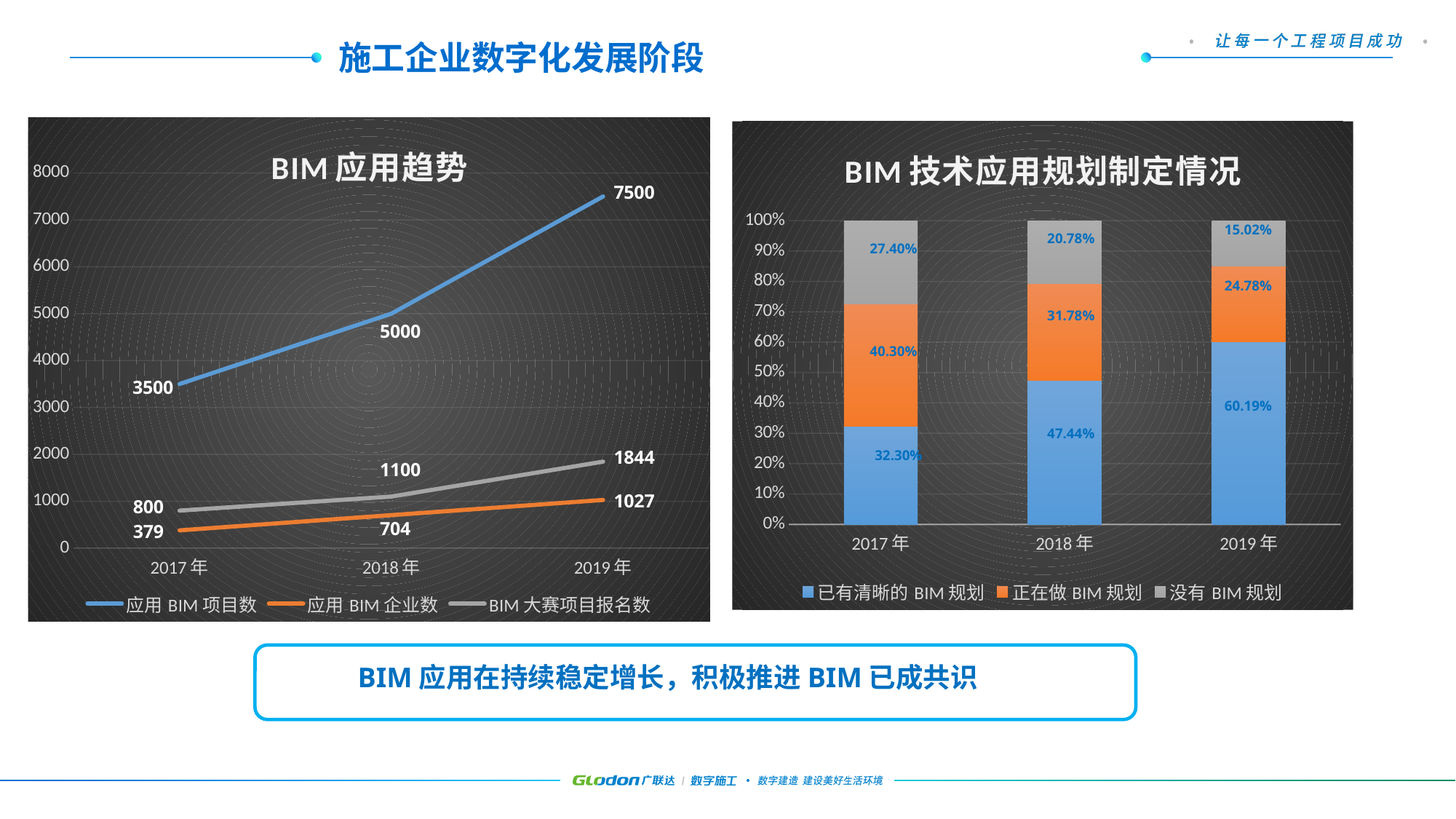
In the 'BIM 技术应用规划制定情况' chart, what is the share of 已有清晰的 BIM 规划 in 2019 年? 60.19% In the 'BIM 应用趋势' chart, does 应用 BIM 企业数 rise or fall from 2017 年 to 2019 年? rise In the 'BIM 应用趋势' chart, how many series does the legend list? 3 In the 'BIM 技术应用规划制定情况' chart, what is the share of 没有 BIM 规划 in 2017 年? 27.40% What kind of chart is 'BIM 技术应用规划制定情况'? stacked bar chart In the 'BIM 应用趋势' chart, what is the value of BIM 大赛项目报名数 in 2017 年? 800 What kind of chart is 'BIM 应用趋势'? line chart In the 'BIM 技术应用规划制定情况' chart, which is larger in 2018 年: 正在做 BIM 规划 or 没有 BIM 规划? 正在做 BIM 规划 In the 'BIM 技术应用规划制定情况' chart, which year has the highest share of 已有清晰的 BIM 规划? 2019 年 In the 'BIM 应用趋势' chart, what is the value of 应用 BIM 企业数 in 2018 年? 704 In the 'BIM 应用趋势' chart, what is the value of 应用 BIM 项目数 in 2019 年? 7500 In the 'BIM 应用趋势' chart, what is the difference between 应用 BIM 项目数 in 2019 年 and 2018 年? 2500